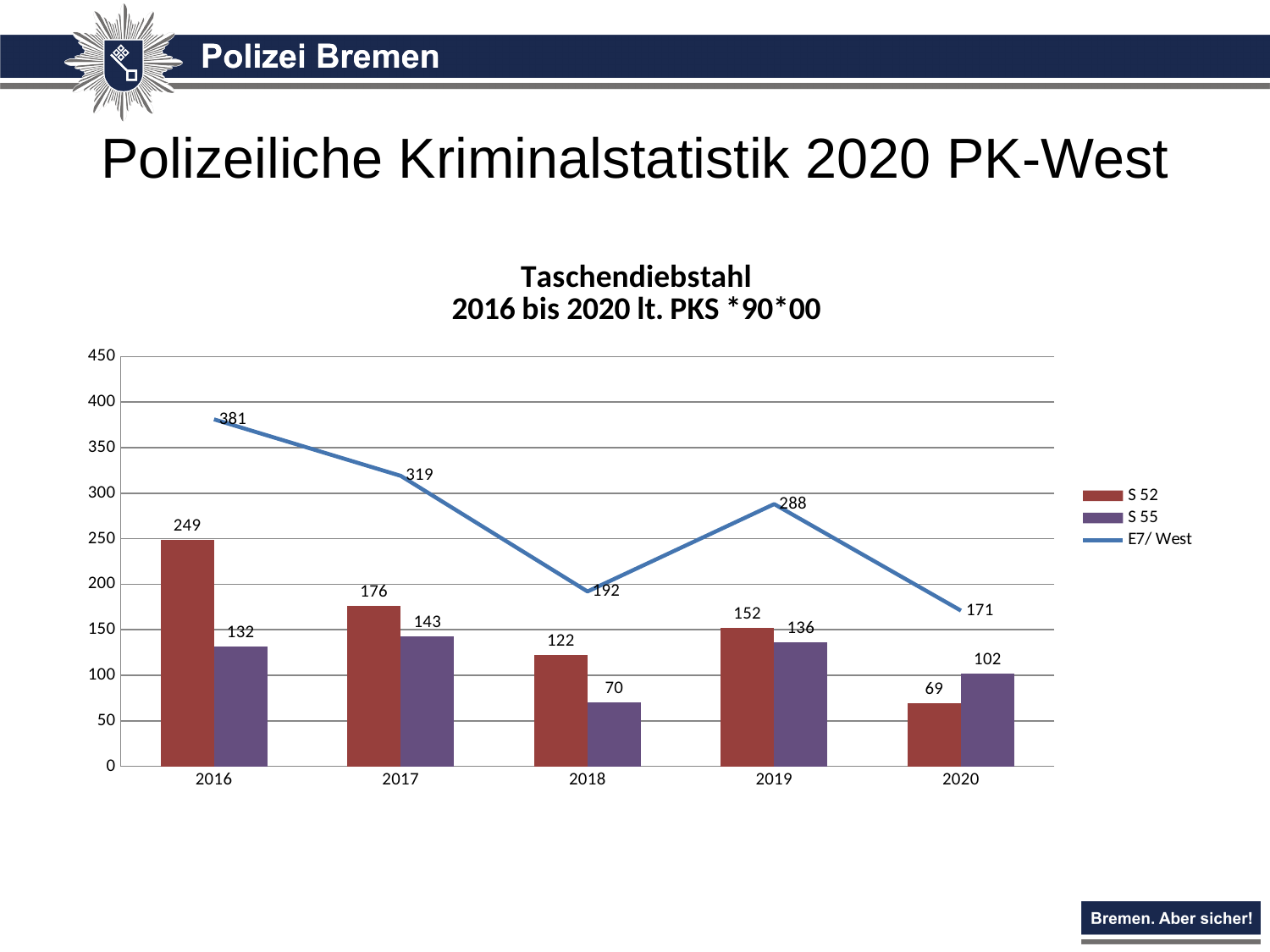
What is the value for S 55 in 2018? 70 How many series does the legend list? 3 What is the value for E7/ West in 2019? 288 In which year is the S 52 value lowest? 2020 Which is larger in 2020, S 52 or S 55? S 55 What is the value for S 52 in 2016? 249 In which year is the E7/ West line highest? 2016 Does the S 52 series rise or fall from 2016 to 2020? Fall What is the title of the chart? Taschendiebstahl 2016 bis 2020 lt. PKS *90*00 What kind of chart is this? Combined bar and line chart How many years are shown on the x axis? 5 What is the difference between the E7/ West values for 2016 and 2017? 62